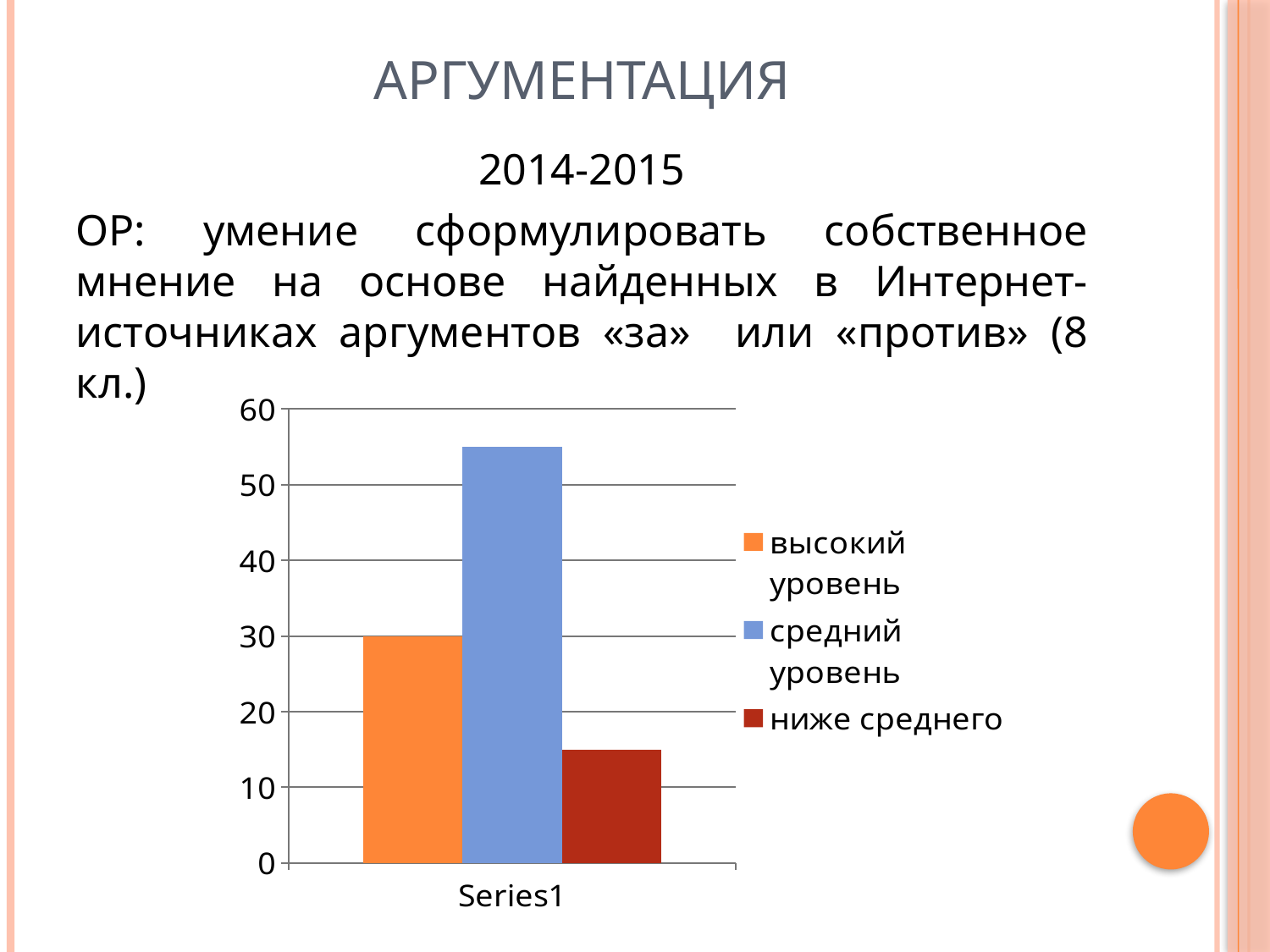
Which is larger, the value for высокий уровень or the value for ниже среднего? высокий уровень What colour is the bar for средний уровень? blue What kind of chart is shown on the slide? bar chart Is the value for ниже среднего greater or less than 20? less What is the value for высокий уровень? 30 Which series has the shortest bar? ниже среднего Is the value for средний уровень greater or less than 50? greater Which series has the tallest bar? средний уровень What is the category label shown on the x axis? Series1 Which is larger, the value for средний уровень or the value for высокий уровень? средний уровень How many series does the legend list? 3 Is the value for высокий уровень greater or less than 40? less